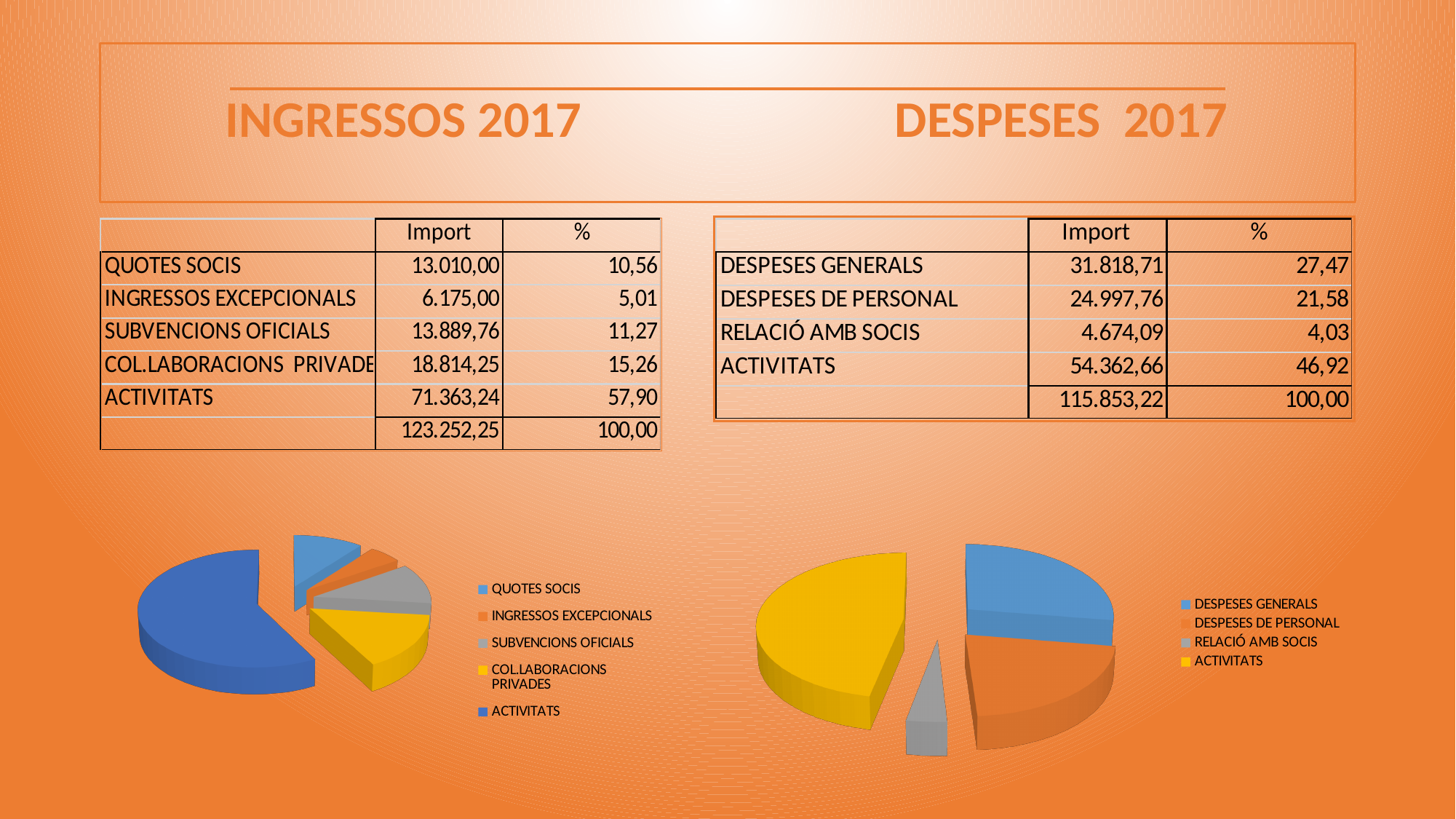
According to the INGRESSOS 2017 table, what is the Import for SUBVENCIONS OFICIALS? 13.889,76 In the INGRESSOS 2017 chart on the left, which category has the largest slice? ACTIVITATS How many slices does the INGRESSOS 2017 pie chart on the left have? 5 How many slices does the DESPESES 2017 pie chart on the right have? 4 What is the total Import shown for INGRESSOS 2017? 123.252,25 In the DESPESES 2017 chart on the right, which is larger: DESPESES GENERALS or DESPESES DE PERSONAL? DESPESES GENERALS In the DESPESES 2017 chart on the right, which category has the smallest slice? RELACIÓ AMB SOCIS According to the DESPESES 2017 table, what percentage share does DESPESES DE PERSONAL have? 21,58 In the DESPESES 2017 chart on the right, which category has the largest slice? ACTIVITATS What kind of chart is the INGRESSOS 2017 chart on the left? pie chart In the DESPESES 2017 chart on the right, what colour is the ACTIVITATS slice? yellow In the INGRESSOS 2017 chart on the left, which category has the smallest slice? INGRESSOS EXCEPCIONALS